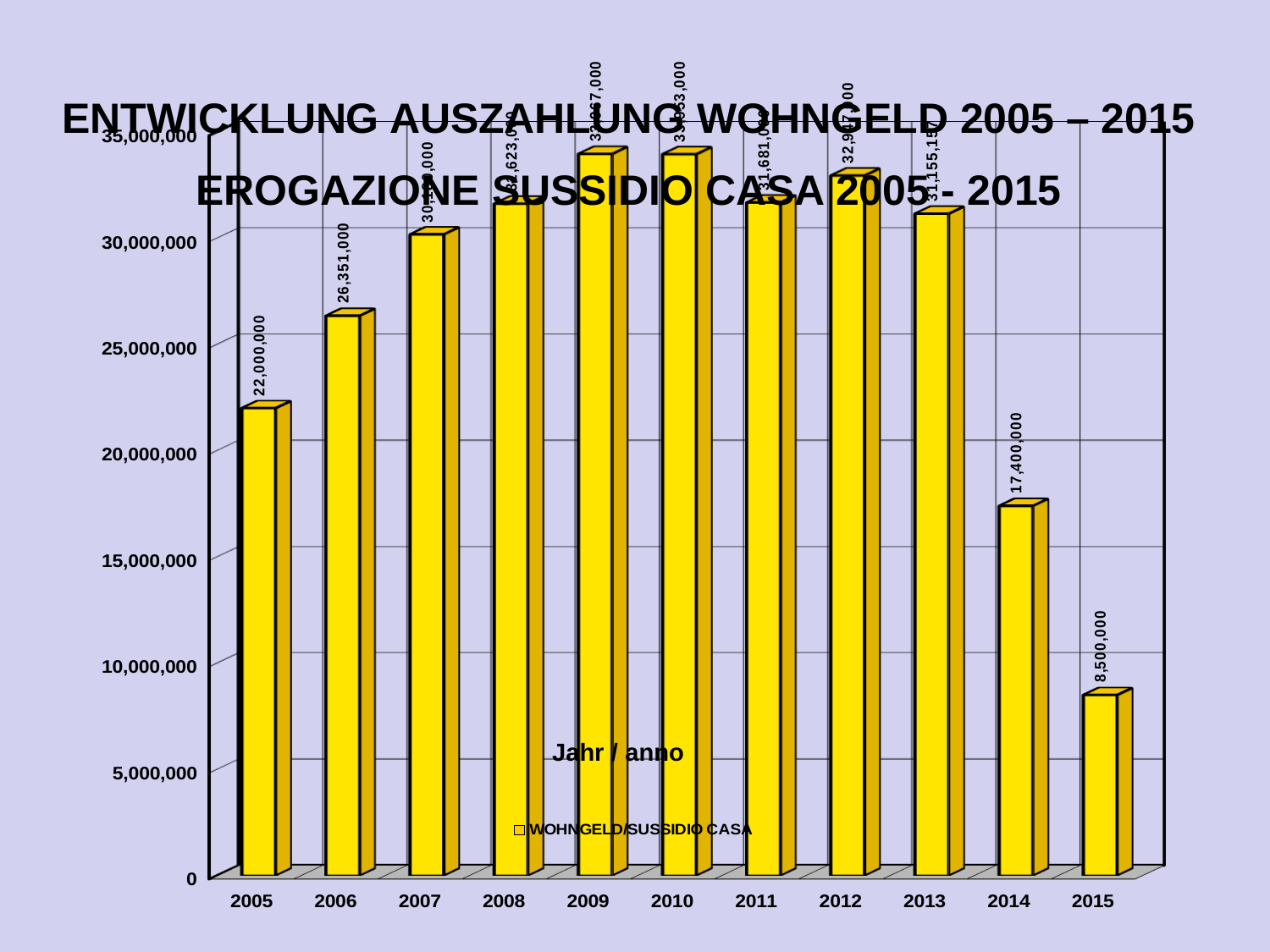
What is the difference between the values for 2006 and 2005? 4,351,000 Which is larger, the value for 2006 or the value for 2014? 2006 What is the value for 2015? 8,500,000 What series name does the legend show? WOHNGELD/SUSSIDIO CASA What is the value for 2005? 22,000,000 What is the value for 2006? 26,351,000 How many years are shown on the x axis? 11 What is the value for 2014? 17,400,000 Which year has the lowest value? 2015 Is the value for 2008 greater or less than 30,000,000? greater What is the difference between the values for 2014 and 2015? 8,900,000 What kind of chart is shown? bar chart